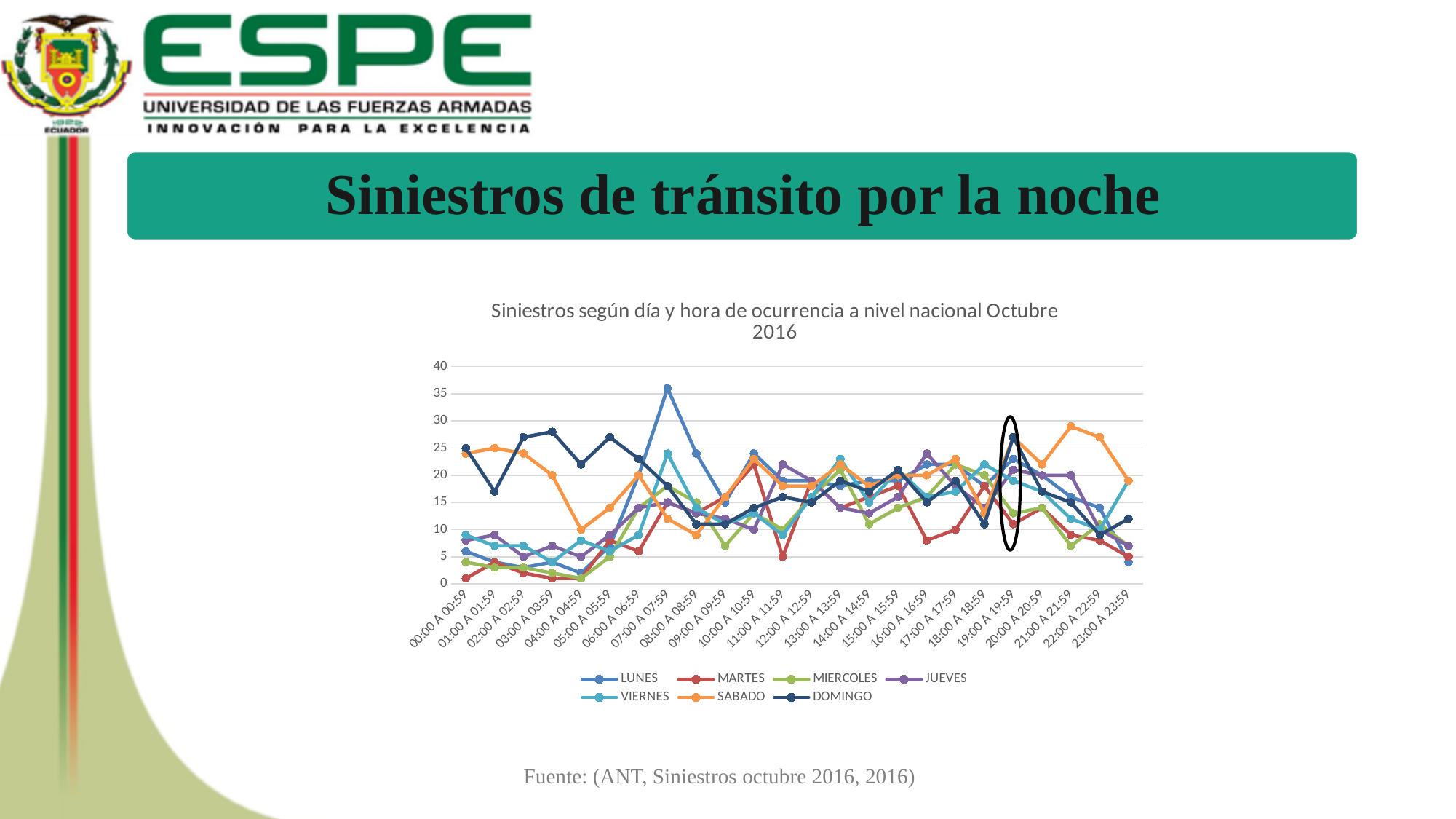
Is the value for LUNES at 07:00 A 07:59 greater or less than 30? greater Which series has the highest value at 21:00 A 21:59? SABADO At 21:00 A 21:59, which is larger, the value for SABADO or the value for MIERCOLES? SABADO Which series has the highest value at 07:00 A 07:59? LUNES Which series reaches the highest value anywhere on the chart? LUNES At 07:00 A 07:59, which is larger, the value for LUNES or the value for MARTES? LUNES What is the title of the chart? Siniestros según día y hora de ocurrencia a nivel nacional Octubre 2016 Is the value for MIERCOLES at 04:00 A 04:59 greater or less than 5? less How many series does the legend of the chart list? 7 What kind of chart is shown on the slide? Line chart Which series has the lowest value at 00:00 A 00:59? MARTES How many hourly categories are shown along the x axis of the chart? 24